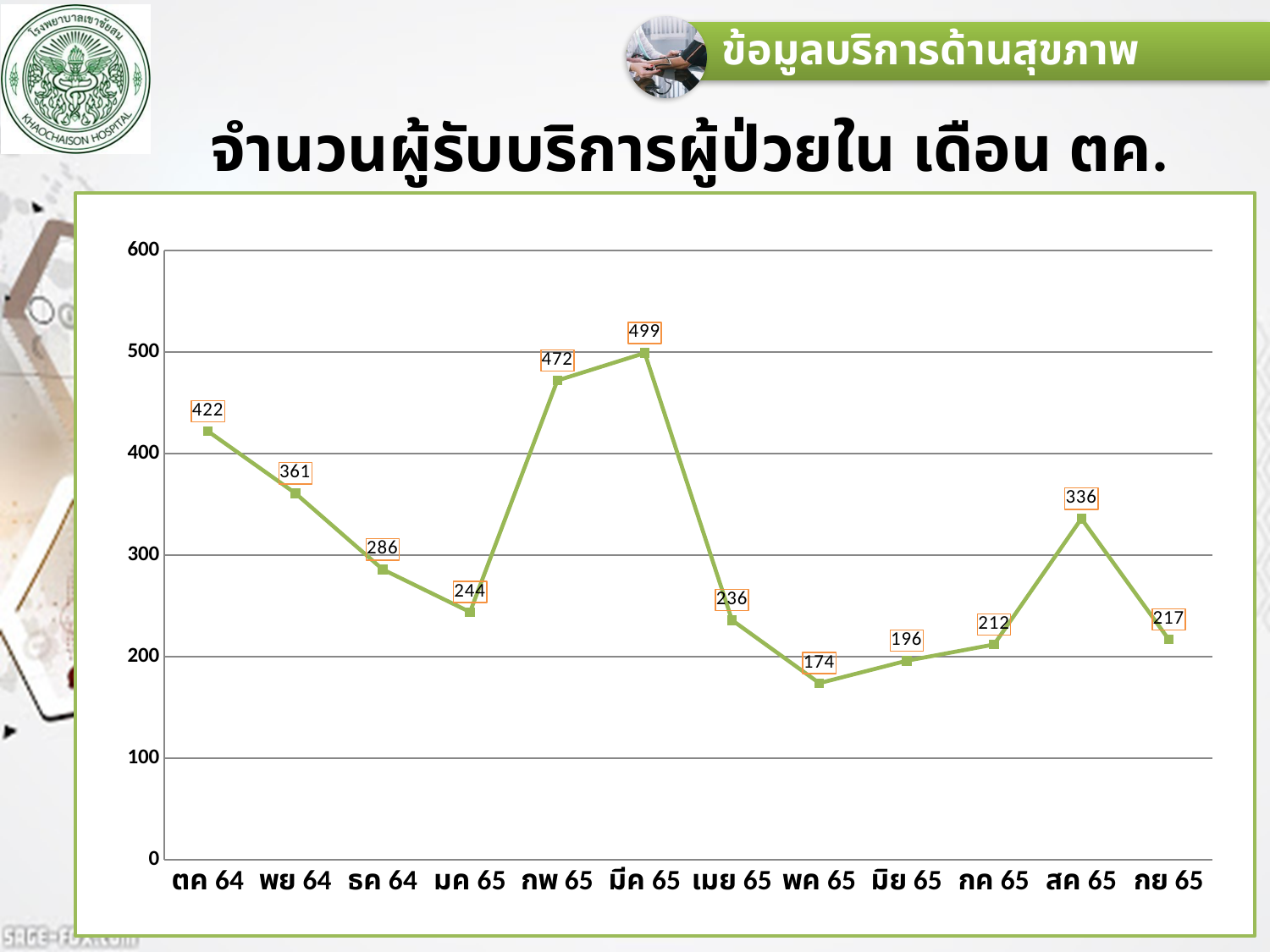
What is the difference between the values for ตค 64 and พย 64? 61 What is the value for มีค 65? 499 Which month has the lowest value? พค 65 What is the value for ตค 64? 422 Do the values rise or fall from ตค 64 to มค 65? fall What is the value for พค 65? 174 Which month has the highest value? มีค 65 What is the difference between the values for มีค 65 and เมย 65? 263 How many months are plotted on the x axis? 12 What kind of chart is shown? line chart Which is larger, the value for สค 65 or the value for กย 65? สค 65 Is the value for กพ 65 greater or less than 400? greater